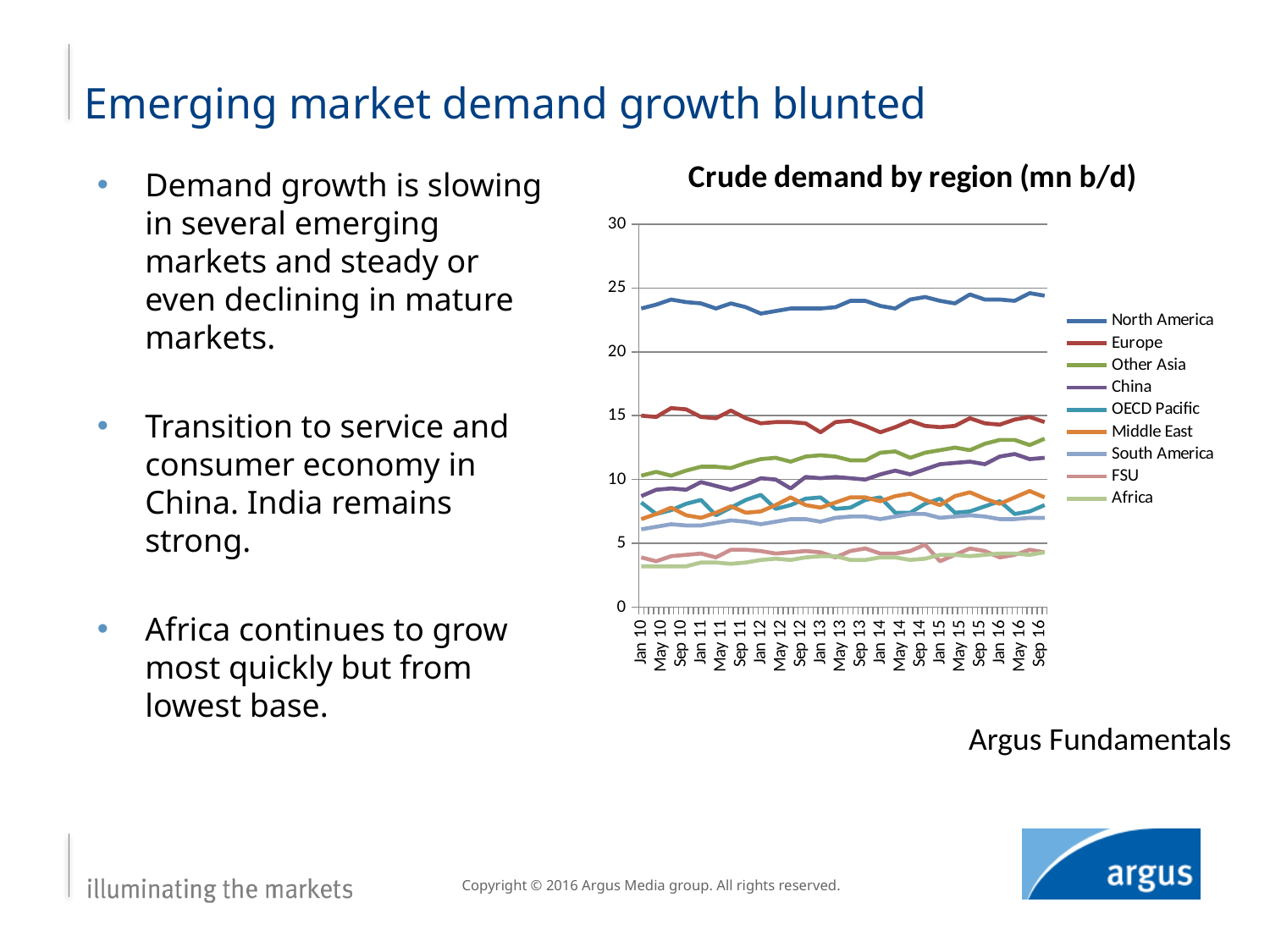
Is the value for Other Asia in Sep 16 greater or less than 10? greater What is the title of the chart? Crude demand by region (mn b/d) Is the value for Europe in Jan 10 greater or less than 10? greater Which region has the highest crude demand throughout the chart? North America Does the value for Other Asia rise or fall from Jan 10 to Sep 16? Rise What kind of chart is shown on the slide? Line chart How many series does the legend of the chart list? 9 What is the first label on the x axis of the chart? Jan 10 Is the value for North America in Sep 16 greater or less than 20? greater Which is larger in Sep 16, the value for Europe or the value for China? Europe